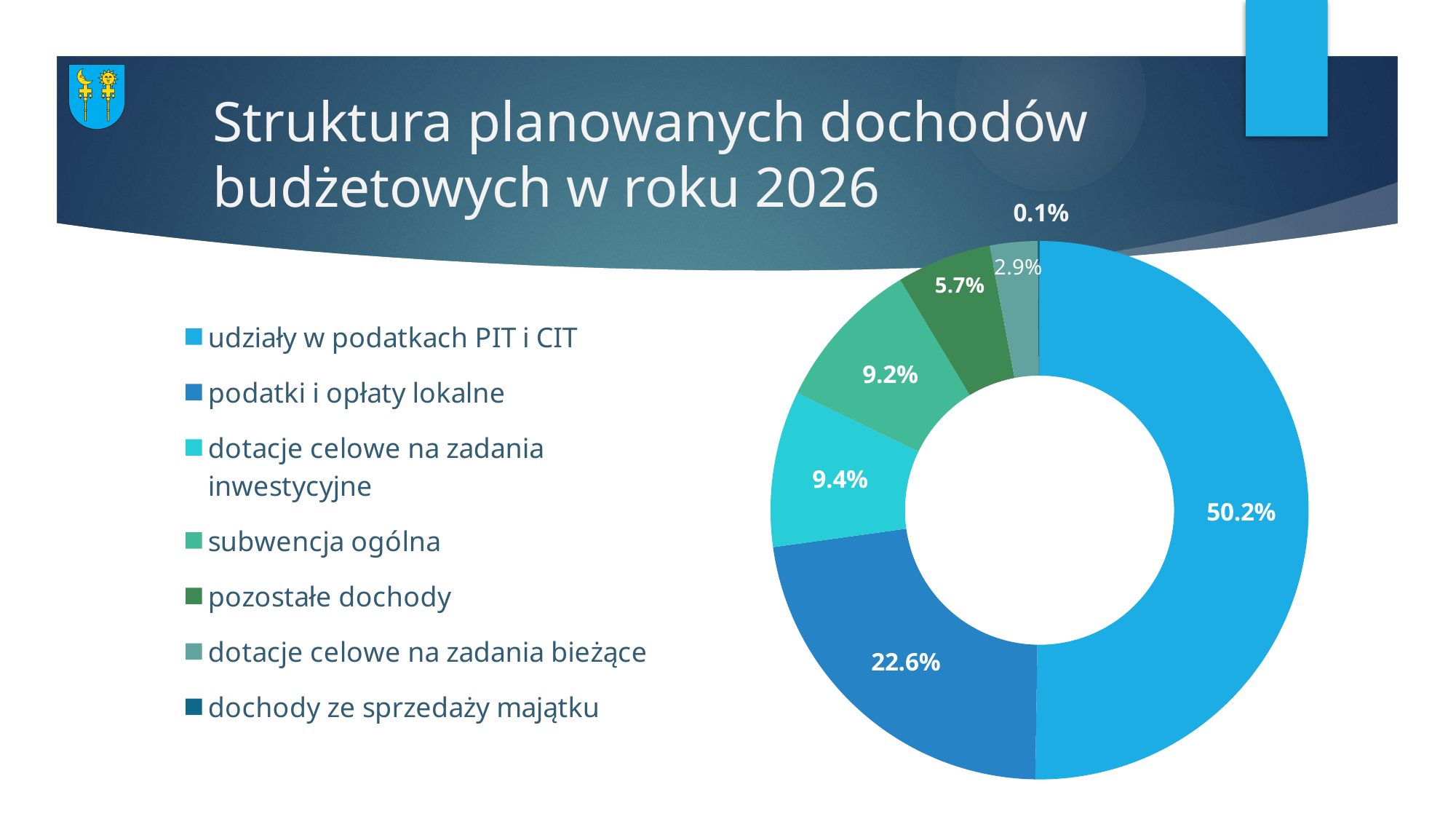
What share of planned budget revenue in 2026 comes from udziały w podatkach PIT i CIT? 50.2% How many categories does the legend list? 7 What share is shown for dotacje celowe na zadania inwestycyjne? 9.4% What share is shown for podatki i opłaty lokalne? 22.6% What share is shown for dotacje celowe na zadania bieżące? 2.9% What share is shown for pozostałe dochody? 5.7% What is the difference in percentage points between udziały w podatkach PIT i CIT and podatki i opłaty lokalne? 27.6 percentage points What share is shown for subwencja ogólna? 9.2% Which category has the smallest share of planned revenue? dochody ze sprzedaży majątku Which category has the largest share of planned revenue? udziały w podatkach PIT i CIT What kind of chart is shown on the slide? Doughnut (pie) chart What is the title of the slide containing the chart? Struktura planowanych dochodów budżetowych w roku 2026